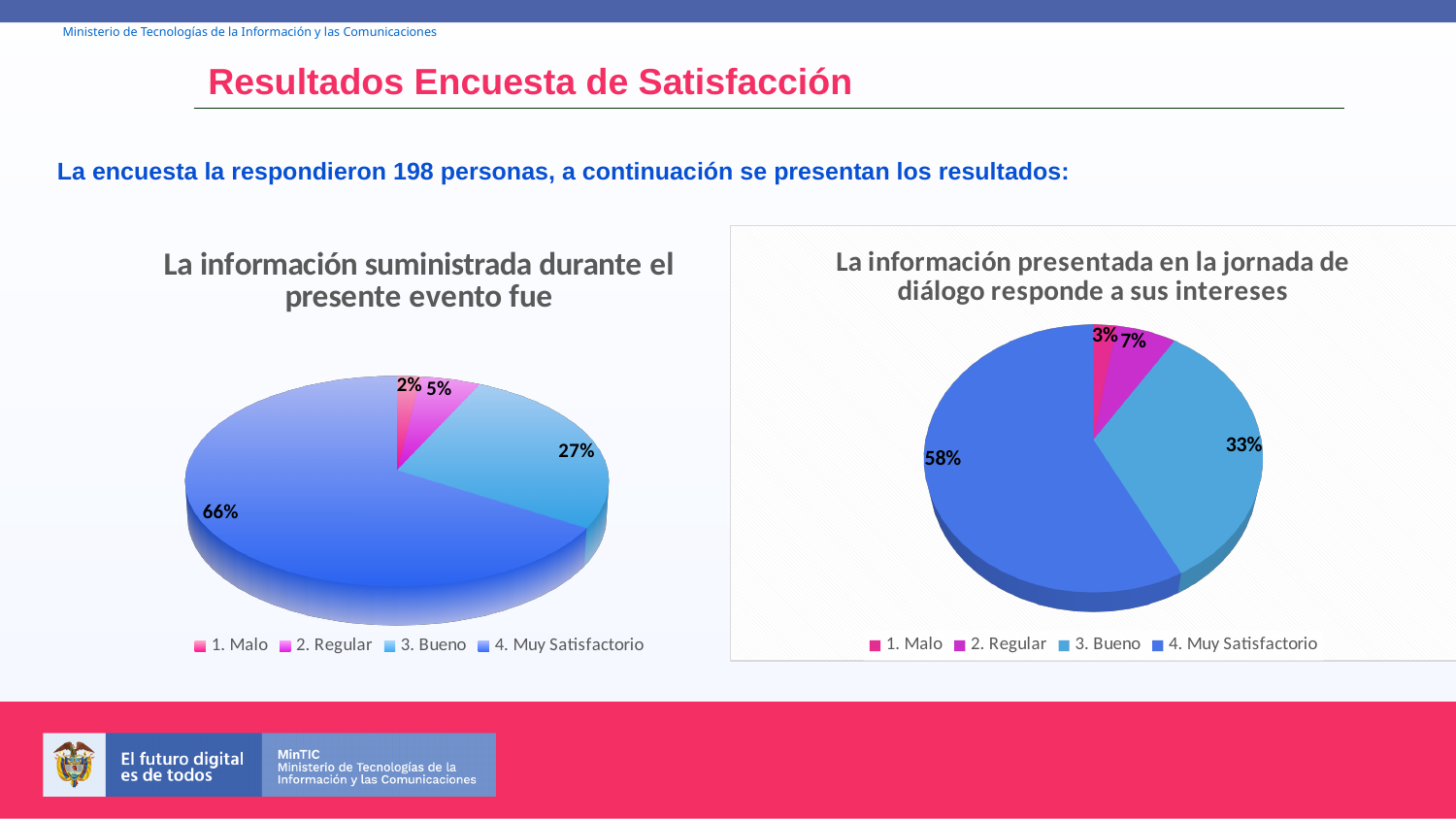
How many categories does the legend of the left chart list? 4 Which is larger: the share for 3. Bueno in the left chart or the share for 3. Bueno in the right chart? The right chart (33%) In the chart titled "La información presentada en la jornada de diálogo responde a sus intereses", what percentage is shown for 1. Malo? 3% In the left chart, what is the difference between the shares for 4. Muy Satisfactorio and 3. Bueno? 39% What is the title of the chart on the left side of the slide? La información suministrada durante el presente evento fue In the chart titled "La información presentada en la jornada de diálogo responde a sus intereses", what percentage is shown for 4. Muy Satisfactorio? 58% In the right chart, what is the difference between the shares for 3. Bueno and 2. Regular? 26% In the chart titled "La información suministrada durante el presente evento fue", what percentage is shown for 4. Muy Satisfactorio? 66% In the chart titled "La información suministrada durante el presente evento fue", what percentage is shown for 3. Bueno? 27% What type of chart is used on the right side of the slide? Pie chart In the right chart, which category has the largest share? 4. Muy Satisfactorio In the left chart, which category has the smallest share? 1. Malo